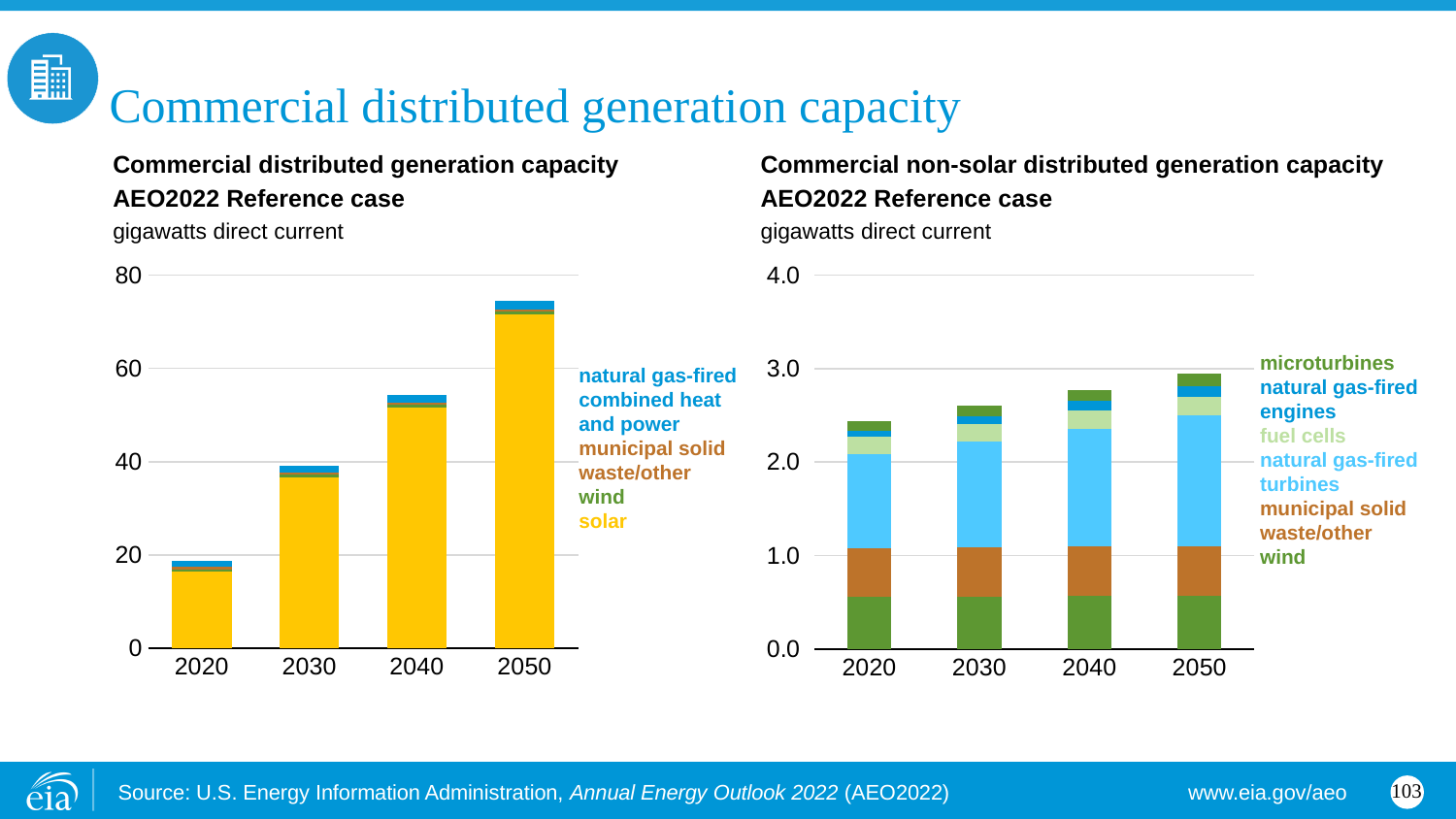
In the 'Commercial distributed generation capacity' chart on the left, which year has the shortest bar? 2020 In the 'Commercial distributed generation capacity' chart on the left, is the total for 2050 greater or less than 60? greater How many series does the legend of the 'Commercial distributed generation capacity' chart on the left list? 4 How many years are shown on the x axis of the 'Commercial non-solar distributed generation capacity' chart on the right? 4 What unit is shown under the title of the 'Commercial non-solar distributed generation capacity' chart on the right? gigawatts direct current What kind of chart is the 'Commercial distributed generation capacity' chart on the left? stacked bar chart In the 'Commercial non-solar distributed generation capacity' chart on the right, do the bar totals rise or fall from 2020 to 2050? rise How many series does the legend of the 'Commercial non-solar distributed generation capacity' chart on the right list? 6 In the 'Commercial distributed generation capacity' chart on the left, which year has the tallest bar? 2050 In the 'Commercial distributed generation capacity' chart on the left, is the total for 2040 greater or less than 40? greater In the 'Commercial distributed generation capacity' chart on the left, which series makes up most of each bar? solar In the 'Commercial non-solar distributed generation capacity' chart on the right, is the total for 2020 greater or less than 2.0? greater